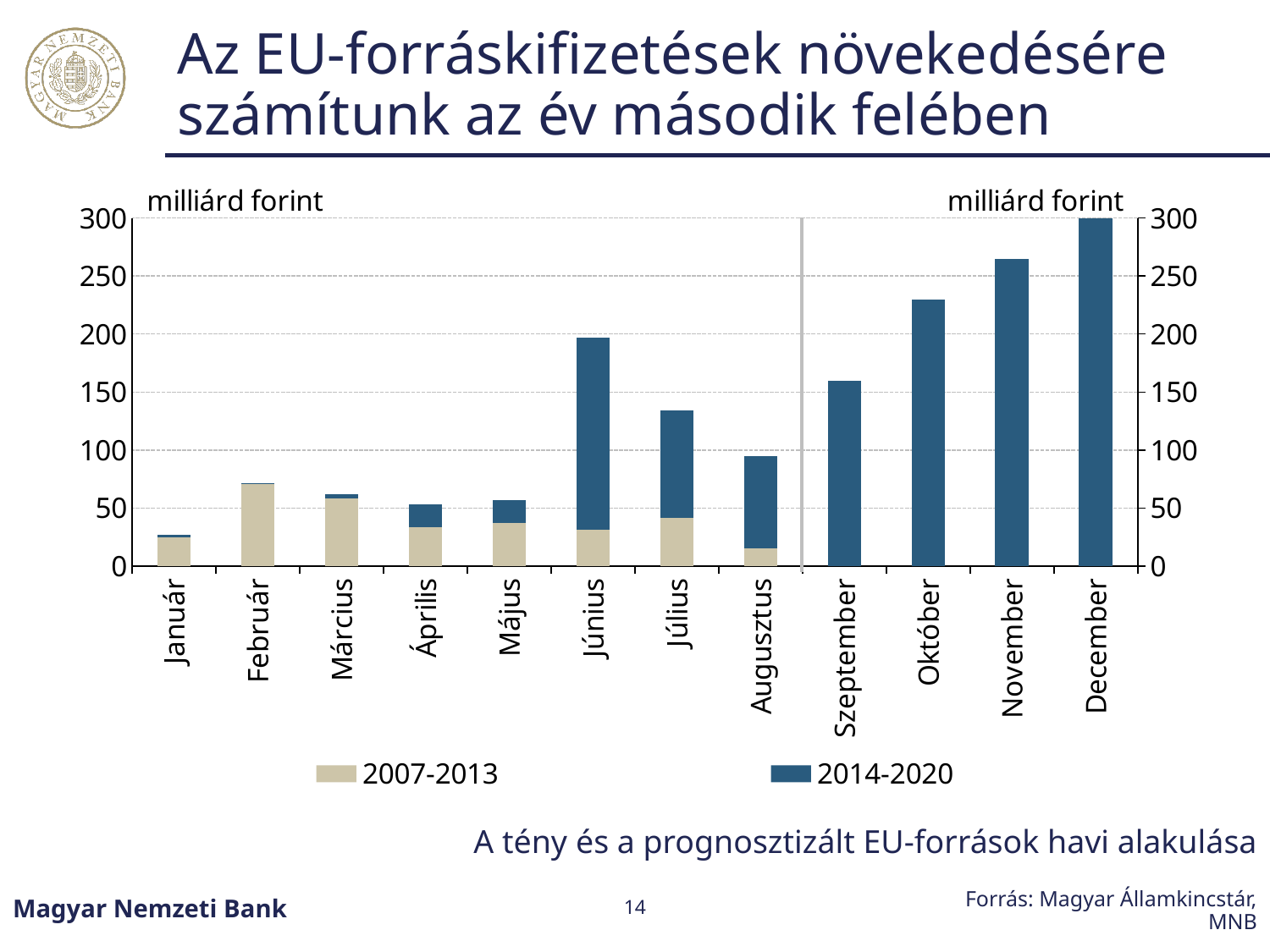
How many series does the legend list? 2 How many months are shown on the x axis? 12 Which month has the larger total bar, Június or Július? Június Do the bars rise or fall from Szeptember to December? Rise Which month has the lowest total bar? Január Is the total value for November greater or less than 250? greater What kind of chart is shown on the slide? Stacked bar chart Is the total value for Október greater or less than 200? greater Is the total value for Január greater or less than 50? less Which month has the highest total bar? December What unit is shown on the vertical axis? milliárd forint